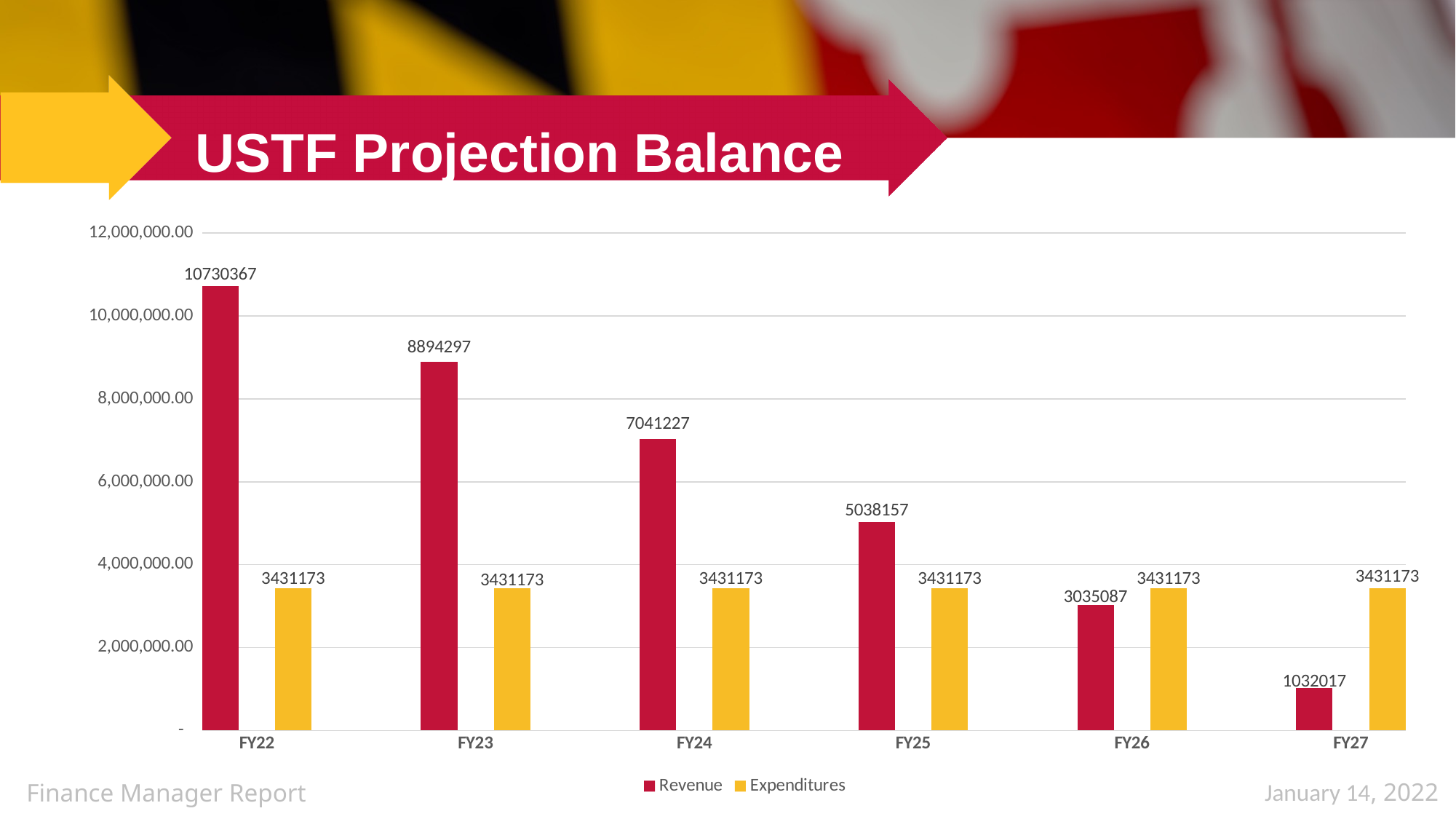
What is the Expenditures value for FY25? 3431173 What is the Revenue value for FY27? 1032017 What is the difference between Revenue and Expenditures in FY24? 3610054 What is the Revenue value for FY22? 10730367 Does Revenue rise or fall from FY22 to FY27? Fall How many series does the legend list? 2 Which fiscal year has the lowest Revenue? FY27 Is the Revenue value for FY23 greater or less than 8,000,000.00? greater What kind of chart is shown on the slide? Bar chart How many fiscal years are shown on the x axis? 6 In FY26, which is larger, Revenue or Expenditures? Expenditures Which fiscal year has the highest Revenue? FY22